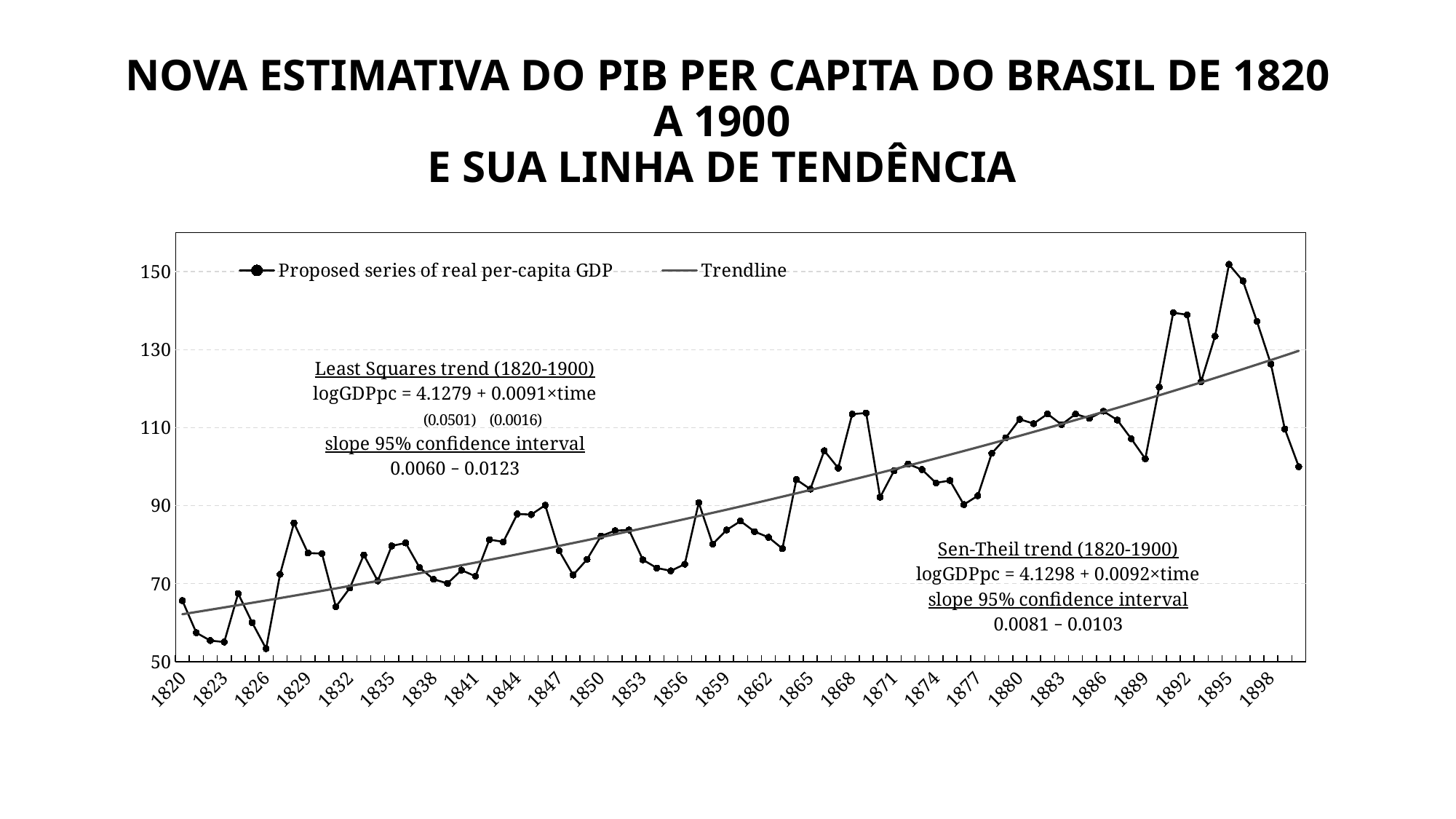
How many series does the legend list? 2 Do the values of the proposed series of real per-capita GDP generally rise or fall from 1820 to 1900? Rise In which year does the proposed series of real per-capita GDP reach its highest value? 1895 According to the text on the chart, what is the slope of the Least Squares trend (1820-1900) equation? 0.0091 Which year has the larger value in the proposed series, 1826 or 1829? 1829 Is the value of the proposed series for 1820 greater or less than 70? less What kind of chart is shown on the slide? Line chart Is the value of the proposed series for 1826 greater or less than 70? less Is the value of the proposed series for 1895 greater or less than 150? greater What are the two entries in the chart legend? Proposed series of real per-capita GDP; Trendline Which year has the larger value in the proposed series, 1891 or 1898? 1891